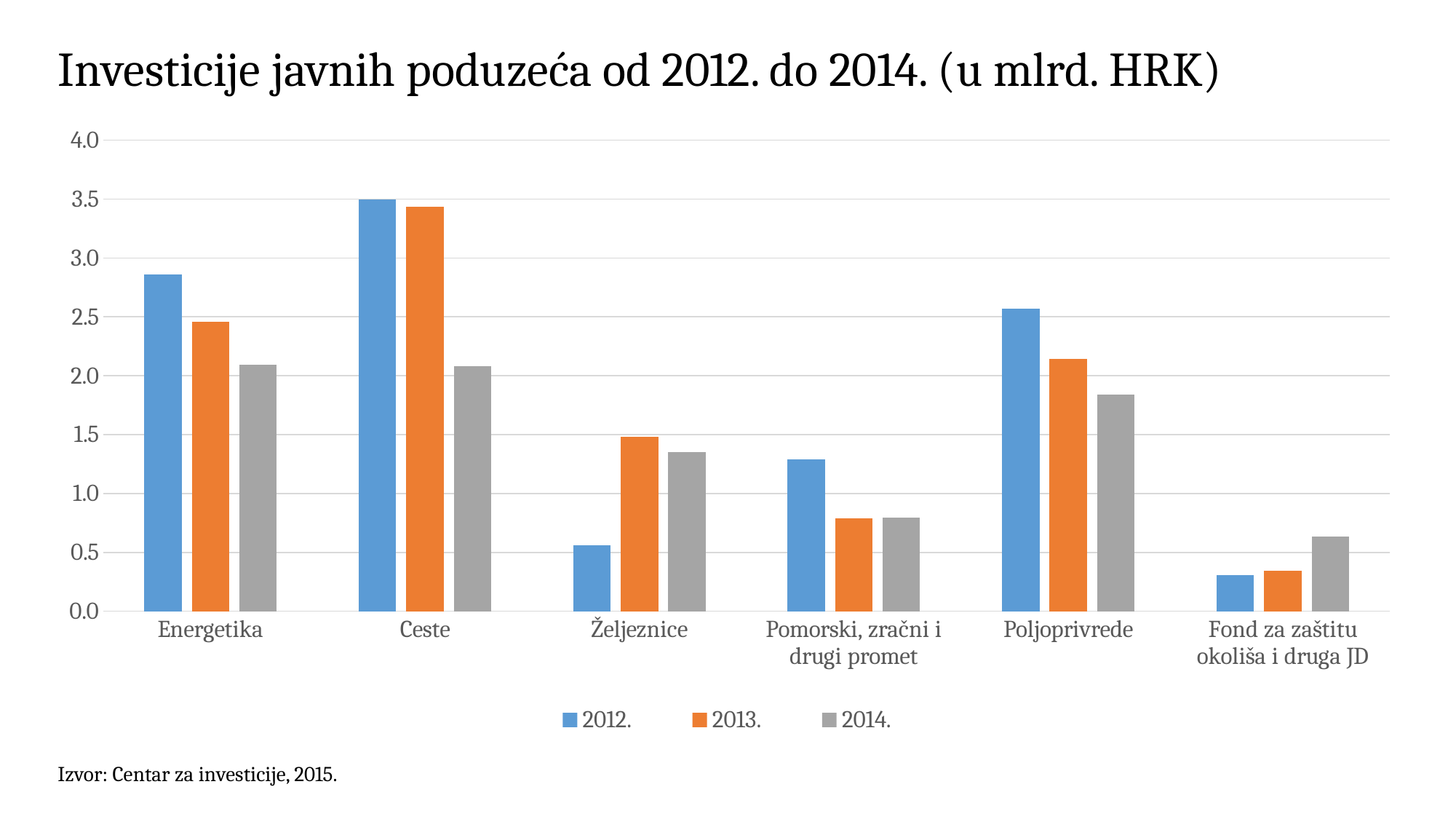
How many categories are shown on the x axis? 6 Which series is shown in orange in the legend? 2013. Do the values for Energetika rise or fall from 2012. to 2014.? fall How many series does the legend list? 3 Is the value for Energetika in 2012. greater or less than 2.5? greater Which is larger for Željeznice: the value for 2013. or the value for 2012.? 2013. What kind of chart is shown on the slide? bar chart Is the value for Željeznice in 2012. greater or less than 1.0? less Is the value for Poljoprivrede in 2014. greater or less than 2.0? less Which category has the lowest value for 2013.? Fond za zaštitu okoliša i druga JD Which category has the highest value for 2012.? Ceste What is the title of the chart? Investicije javnih poduzeća od 2012. do 2014. (u mlrd. HRK)